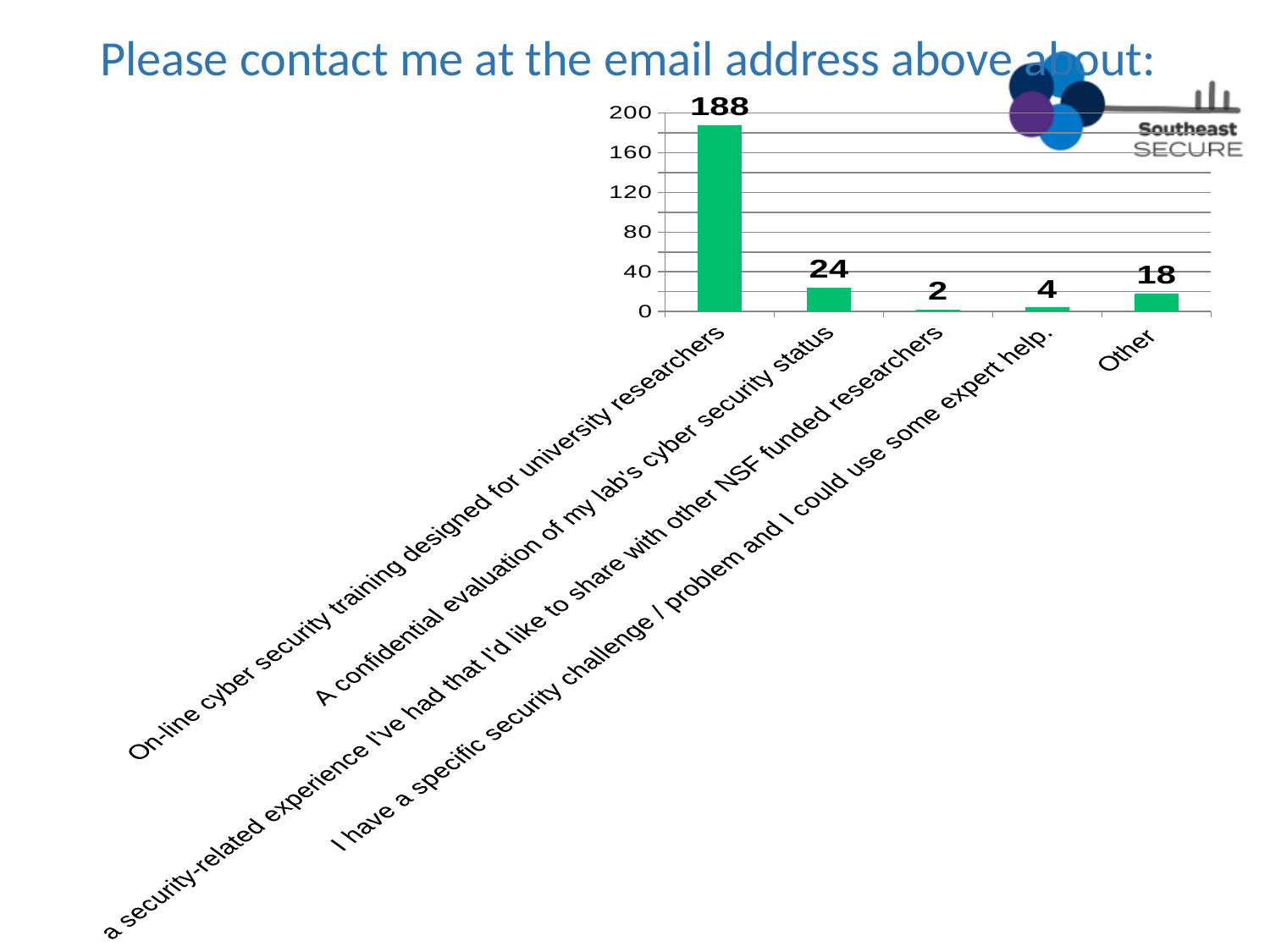
Which category has the lowest value? a security-related experience I've had that I'd like to share with other NSF funded researchers Which is larger, the value for "A confidential evaluation of my lab's cyber security status" or the value for "Other"? A confidential evaluation of my lab's cyber security status How many categories are shown on the x axis? 5 Is the value for "On-line cyber security training designed for university researchers" greater or less than 160? greater What is the title of the slide above the chart? Please contact me at the email address above about: What is the value for "I have a specific security challenge / problem and I could use some expert help."? 4 What is the value for "A confidential evaluation of my lab's cyber security status"? 24 What kind of chart is shown on the slide? bar chart What is the value for "On-line cyber security training designed for university researchers"? 188 What is the value for "Other"? 18 Which category has the highest value? On-line cyber security training designed for university researchers What is the difference between the values for "On-line cyber security training designed for university researchers" and "A confidential evaluation of my lab's cyber security status"? 164